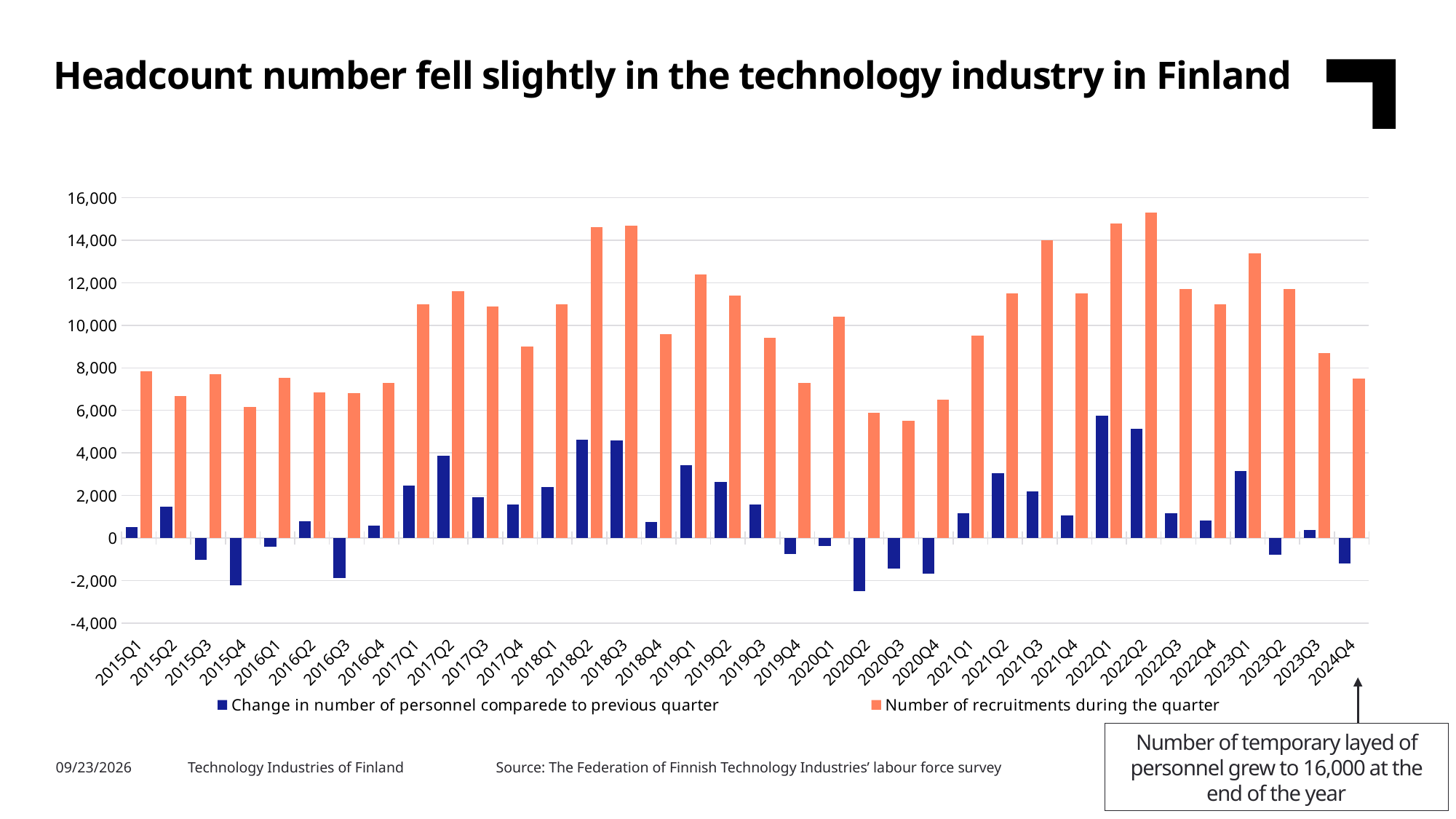
Which quarter has the lowest number of recruitments during the quarter? 2020Q3 Is the change in number of personnel for 2022Q1 greater or less than 4,000? greater Which quarter has the lowest (most negative) change in number of personnel compared to previous quarter? 2020Q2 How many series does the legend list? 2 Is the number of recruitments during the quarter for 2024Q4 greater or less than 8,000? less What colour are the bars for the number of recruitments during the quarter? Orange Which quarter has the largest change in number of personnel compared to previous quarter? 2022Q1 Which quarter has the highest number of recruitments during the quarter? 2022Q2 Is the number of recruitments during the quarter for 2018Q2 greater or less than 14,000? greater What kind of chart is shown on the slide? Bar chart Which quarter has more recruitments during the quarter, 2018Q3 or 2019Q1? 2018Q3 How many quarters are shown along the x axis? 36